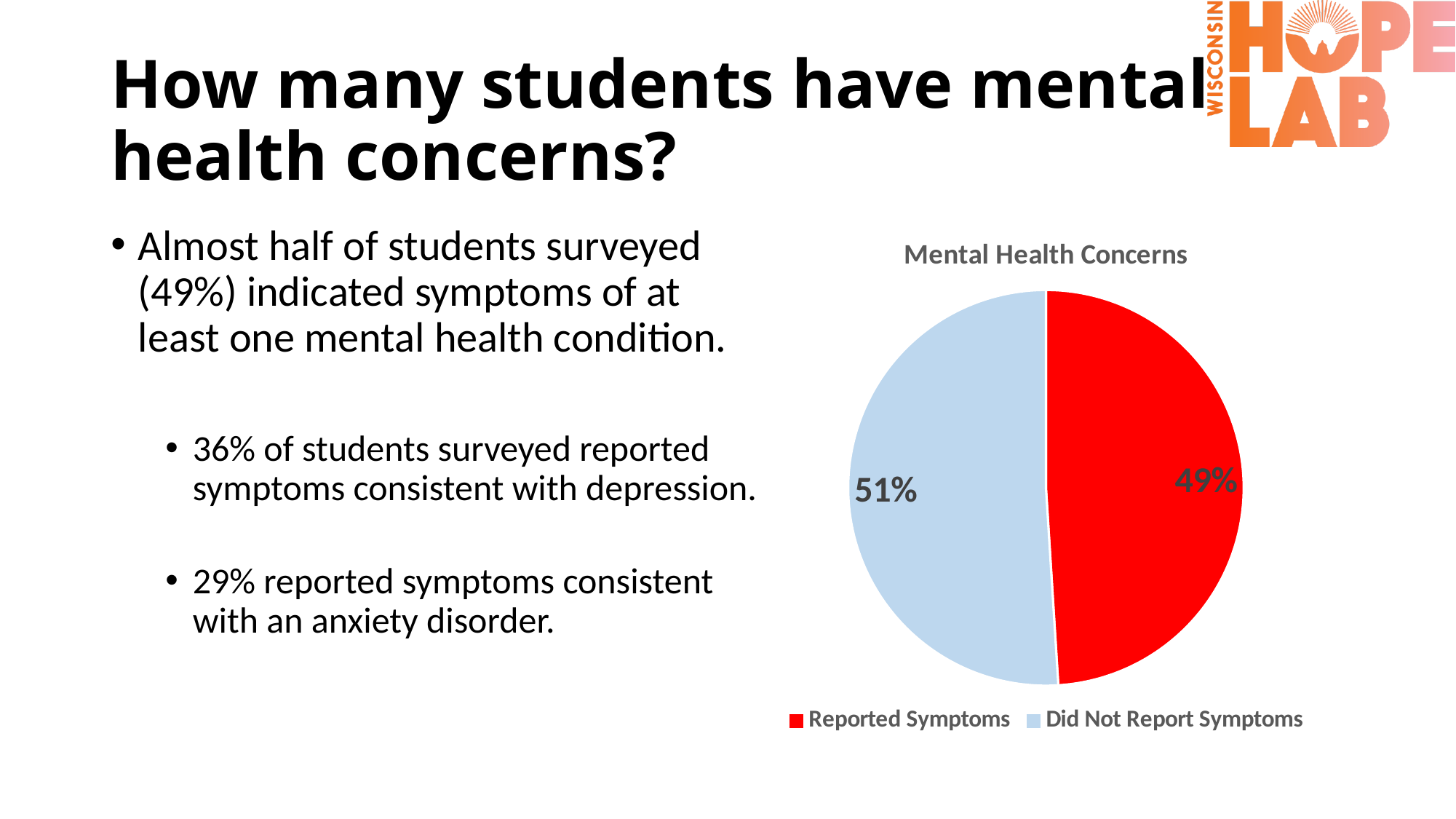
What is the title of the chart? Mental Health Concerns Which slice of the pie chart is the largest? Did Not Report Symptoms What share of the pie is labelled Reported Symptoms? 49% How many slices does the pie chart have? 2 How many entries does the chart legend list? 2 What colour is the Reported Symptoms slice? Red Which slice of the pie chart is the smallest? Reported Symptoms What share of the pie is labelled Did Not Report Symptoms? 51% What is the difference in percentage points between the Did Not Report Symptoms slice and the Reported Symptoms slice? 2 What type of chart is shown on the slide? Pie chart Which is larger, the Reported Symptoms slice or the Did Not Report Symptoms slice? Did Not Report Symptoms What is the total of the two slices shown in the pie chart? 100%